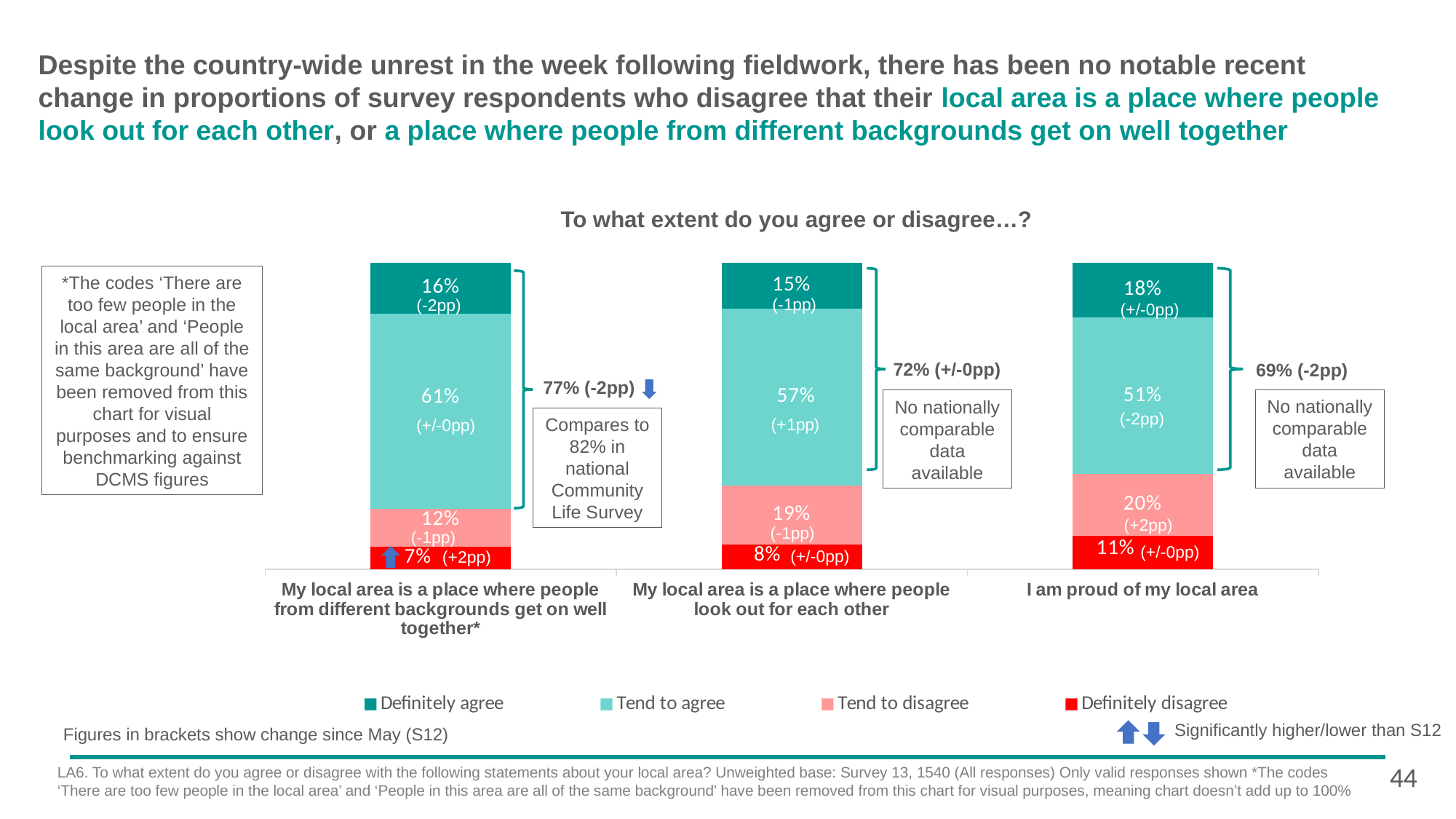
Which is larger: the 'Tend to disagree' share for 'I am proud of my local area' or for 'My local area is a place where people look out for each other'? I am proud of my local area What is the title of the chart? To what extent do you agree or disagree…? How many series does the chart legend list? 4 What percentage of respondents 'Tend to disagree' that their local area is a place where people look out for each other? 19% What is the difference in 'Tend to agree' percentages between 'My local area is a place where people from different backgrounds get on well together*' and 'I am proud of my local area'? 10 percentage points What percentage of respondents 'Tend to agree' that their local area is a place where people from different backgrounds get on well together? 61% What is the combined 'Definitely agree' and 'Tend to agree' percentage for 'My local area is a place where people look out for each other'? 72% Which statement has the highest 'Definitely agree' percentage? I am proud of my local area How many statements (categories) are shown on the x axis of the chart? 3 What percentage of respondents 'Definitely disagree' with the statement 'I am proud of my local area'? 11% What kind of chart is shown on the slide? Stacked bar chart Which statement has the lowest 'Definitely disagree' percentage? My local area is a place where people from different backgrounds get on well together*